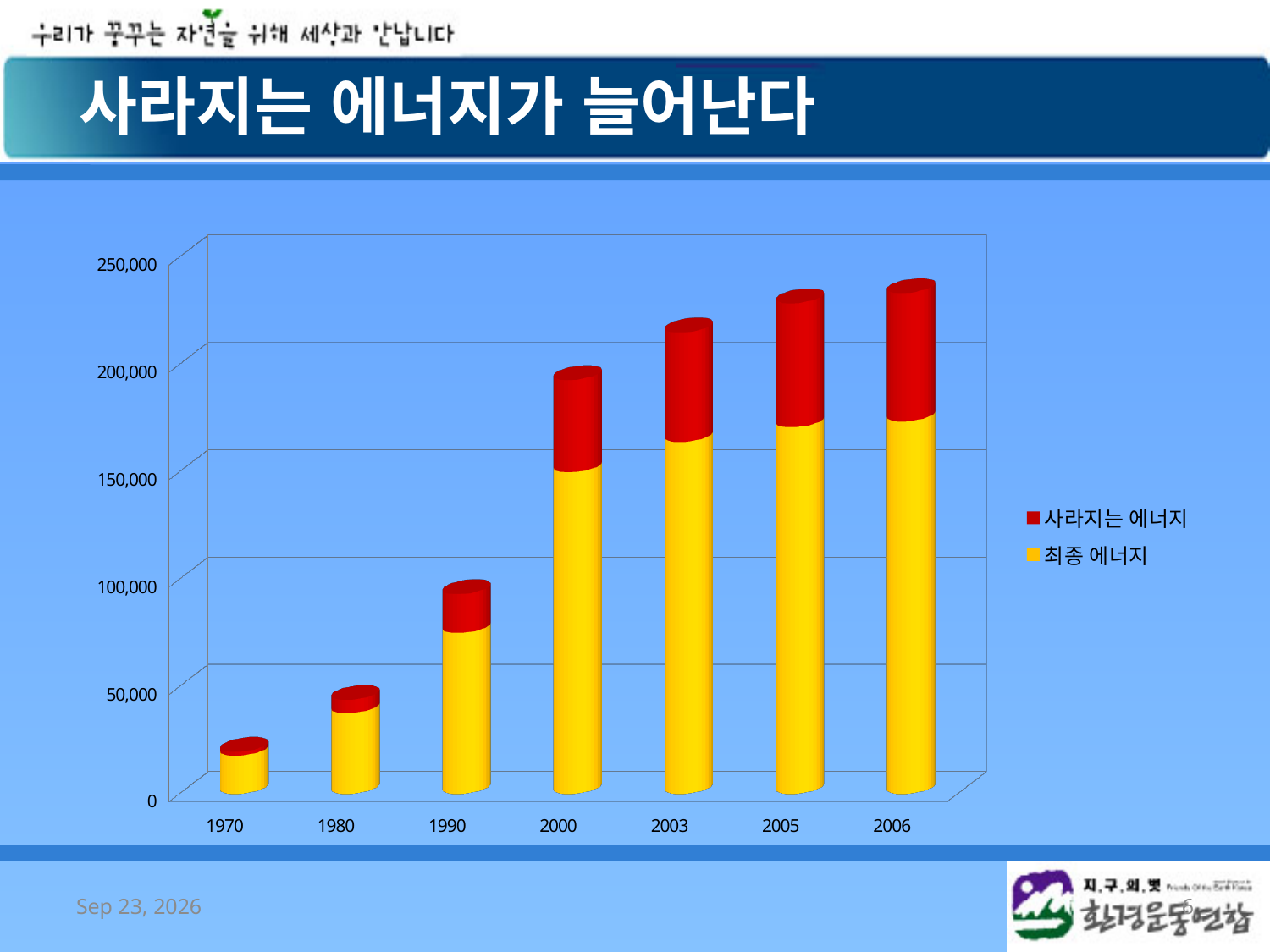
What is the title of the slide containing the chart? 사라지는 에너지가 늘어난다 What kind of chart is shown on the slide? stacked bar chart How many series does the chart's legend list? 2 Do the total bar heights rise or fall from 1970 to 2006? rise Which series is shown in red in the chart? 사라지는 에너지 Is the total bar height for 2006 greater or less than 200,000? greater Which year has the shortest stacked bar in the chart? 1970 Is the total bar height for 1970 greater or less than 50,000? less Which year has the tallest stacked bar in the chart? 2006 Which year has the larger total bar, 1990 or 2000? 2000 Is the 최종 에너지 portion of the 2000 bar greater or less than 100,000? greater How many years are shown along the x axis of the chart? 7